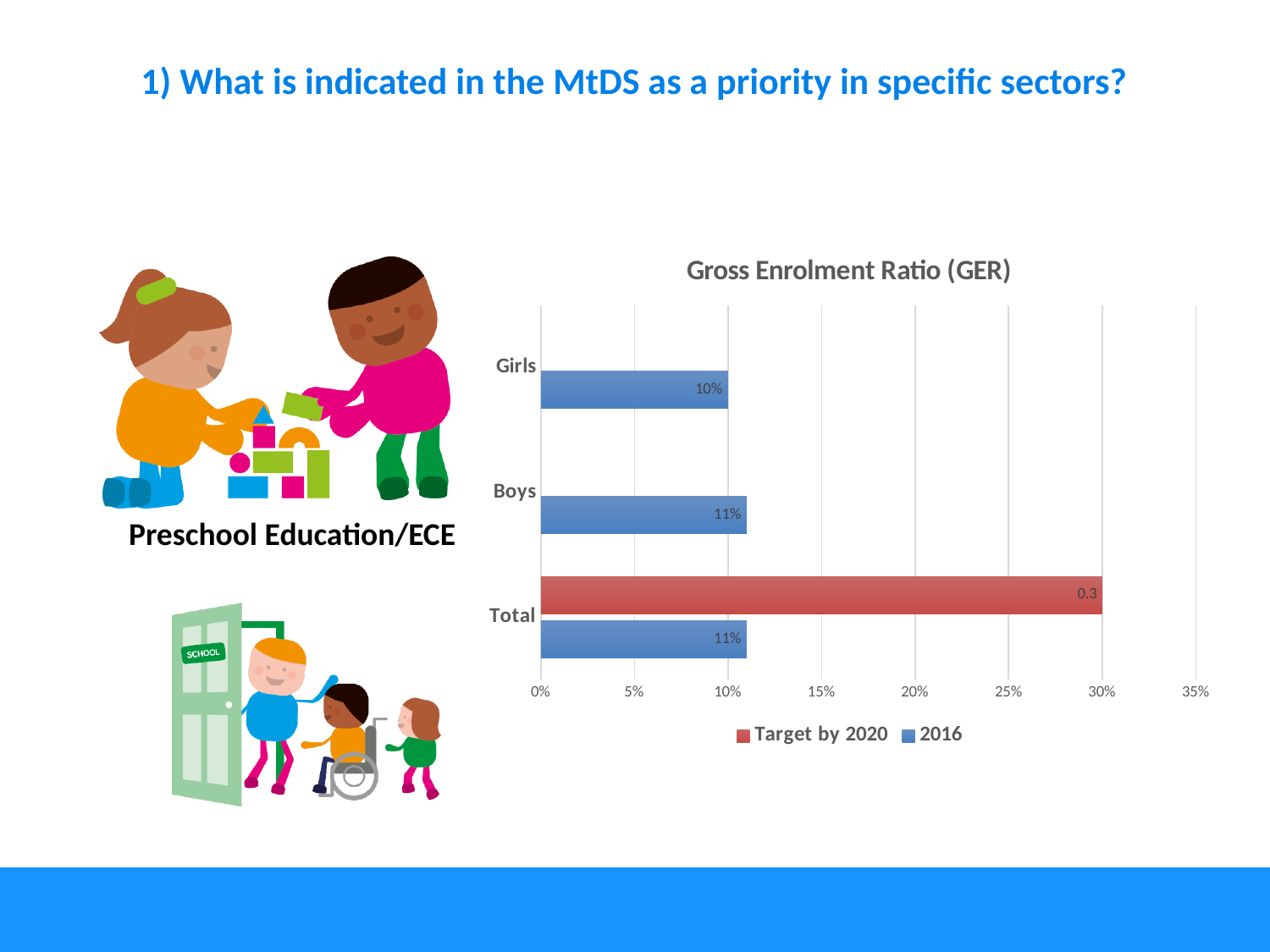
What data label is shown on the Target by 2020 bar for Total? 0.3 What is the 2016 value for Total in the Gross Enrolment Ratio (GER) chart? 11% What is the difference between the 2016 values for Boys and Girls? 1% What is the 2016 value for Boys in the Gross Enrolment Ratio (GER) chart? 11% What kind of chart is the Gross Enrolment Ratio (GER) chart? Bar chart Which series is shown in red in the Gross Enrolment Ratio (GER) chart? Target by 2020 How many categories are shown on the vertical axis of the Gross Enrolment Ratio (GER) chart? 3 Which is larger, the 2016 value for Boys or the 2016 value for Girls? Boys What is the 2016 value for Girls in the Gross Enrolment Ratio (GER) chart? 10% Which category has the lowest 2016 value in the Gross Enrolment Ratio (GER) chart? Girls How many series does the legend of the Gross Enrolment Ratio (GER) chart list? 2 Is the Target by 2020 value for Total greater or less than 25%? greater